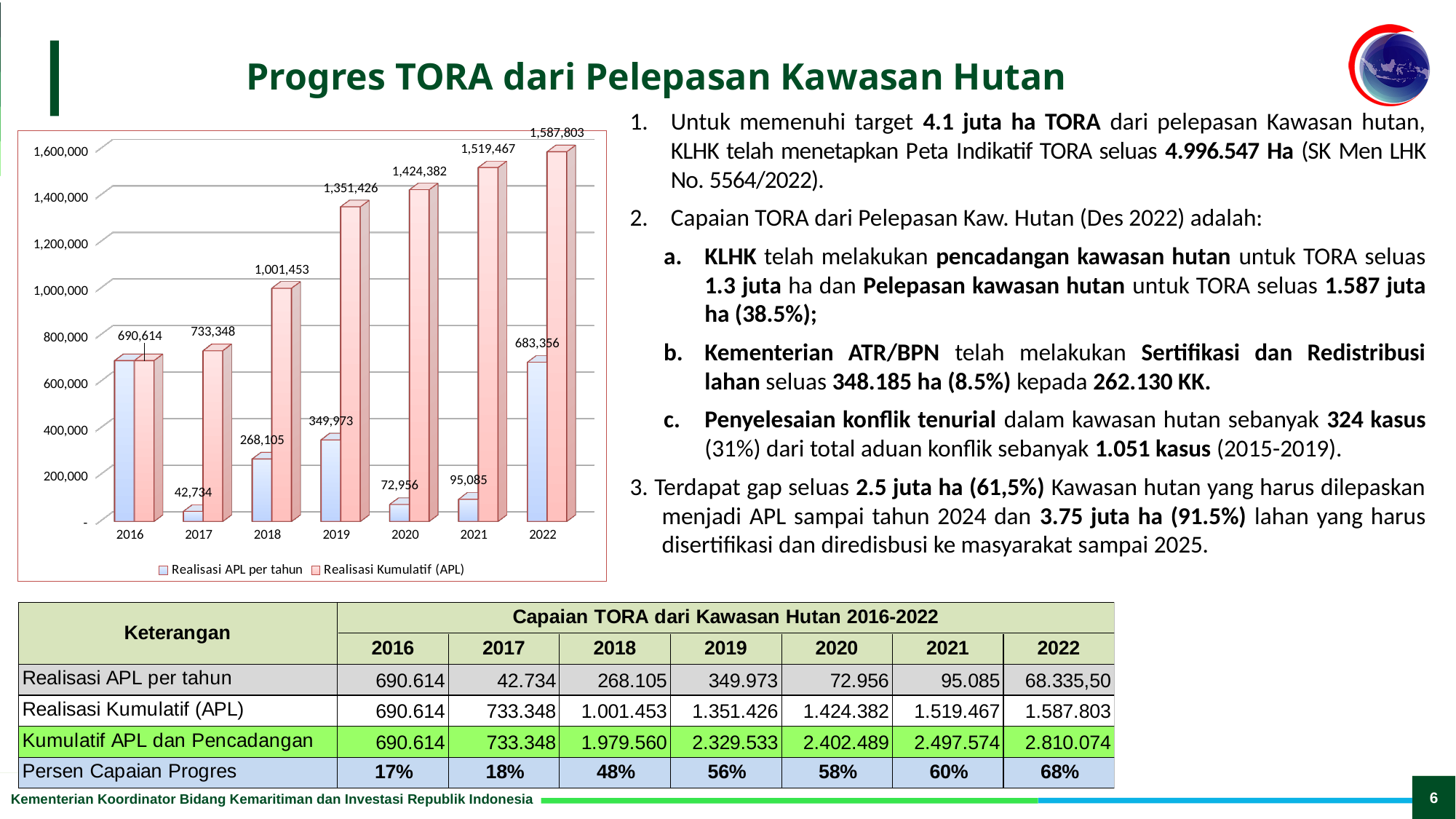
How many years are shown on the x axis of the chart? 7 What kind of chart is shown on the slide? bar chart How many series does the chart legend list? 2 What is the value of Realisasi APL per tahun for 2019? 349,973 What is the value of Realisasi APL per tahun for 2017? 42,734 What is the value of Realisasi Kumulatif (APL) for 2022? 1,587,803 Which year has the highest value for Realisasi Kumulatif (APL)? 2022 What is the difference between Realisasi Kumulatif (APL) in 2022 and in 2021? 68,336 What is the value of Realisasi Kumulatif (APL) for 2018? 1,001,453 Which year has the lowest value for Realisasi APL per tahun? 2017 Which is larger, Realisasi APL per tahun in 2020 or in 2021? 2021 Does the Realisasi Kumulatif (APL) series rise or fall from 2016 to 2022? rise